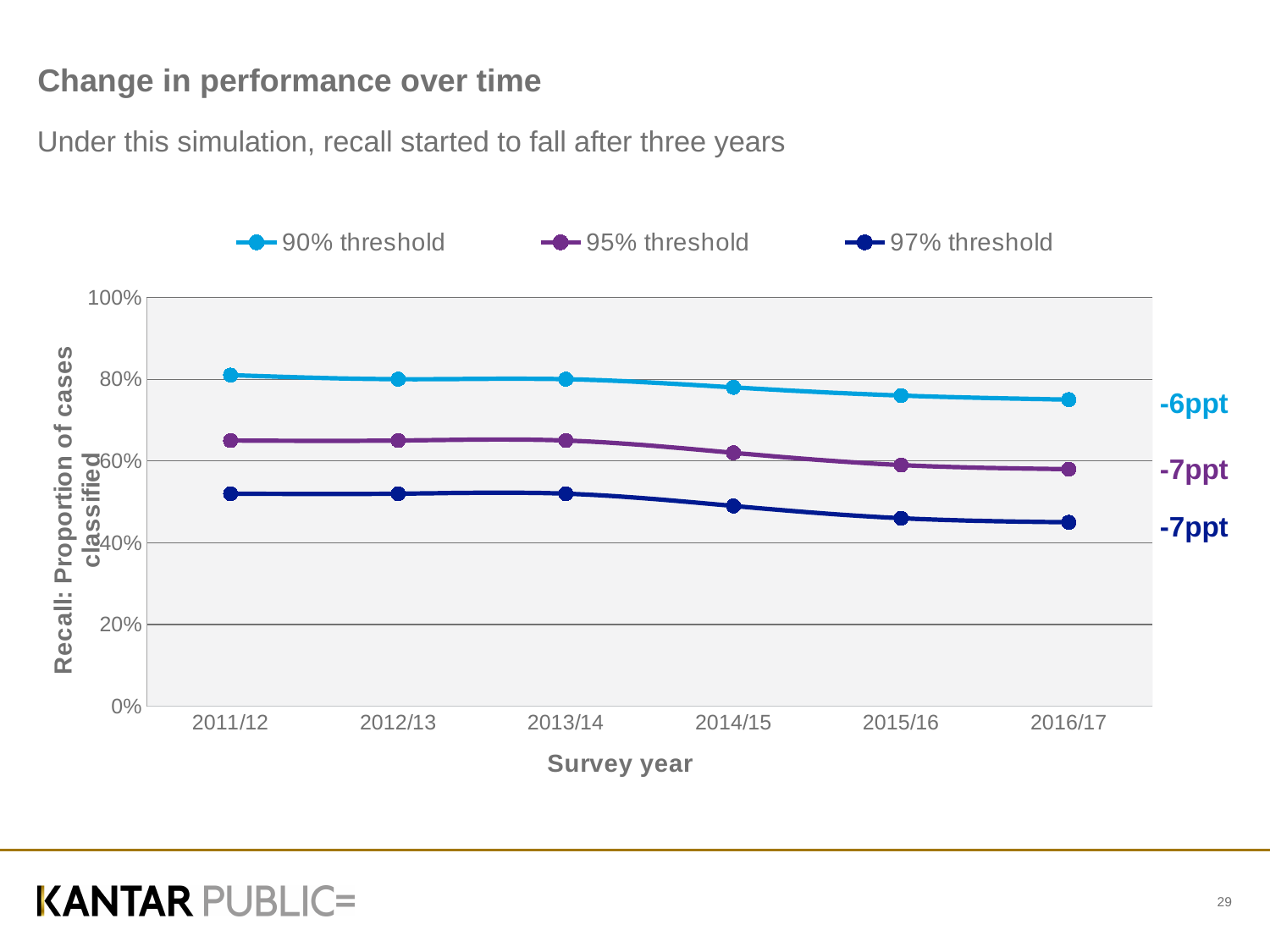
Which series has the lowest recall in 2011/12? 97% threshold Do the values for the 97% threshold rise or fall from 2013/14 to 2016/17? fall What kind of chart is shown on the slide? line chart Which is larger in 2014/15: the 95% threshold value or the 97% threshold value? 95% threshold Is the value for the 97% threshold in 2016/17 greater or less than 60%? less Which series has the highest recall in 2016/17? 90% threshold Is the value for the 95% threshold in 2013/14 greater or less than 60%? greater How many survey years are plotted along the x axis? 6 What is the label of the x axis? Survey year How many series does the legend list? 3 What change in percentage points is annotated for the 90% threshold series? -6ppt